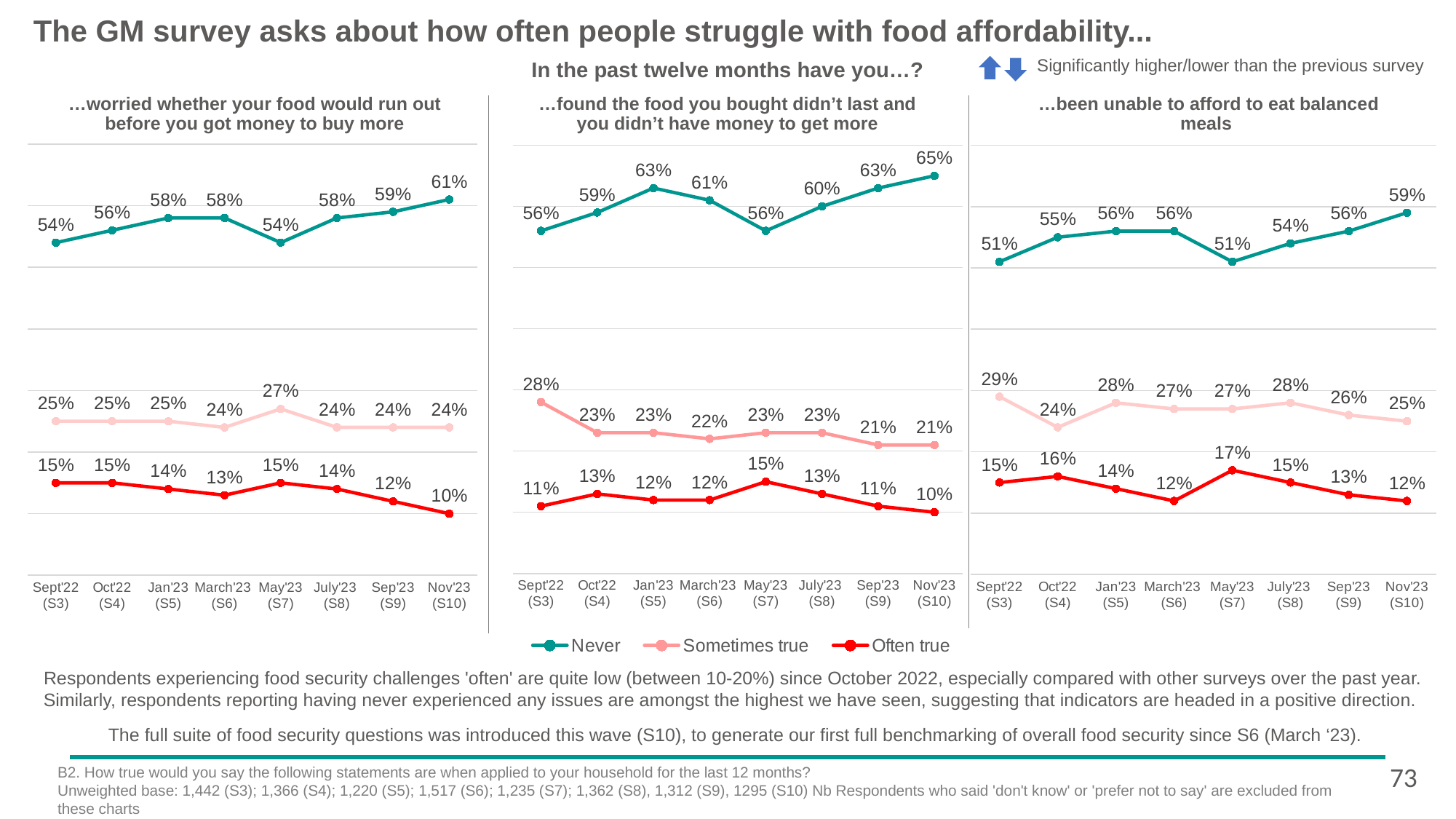
In the chart '…been unable to afford to eat balanced meals', what is the 'Sometimes true' value for Sept'22 (S3)? 29% How many survey waves are plotted along the x axis of each chart? 8 What kind of chart is used for '…found the food you bought didn't last and you didn't have money to get more'? Line chart In the chart '…found the food you bought didn't last and you didn't have money to get more', what is the 'Often true' value for May'23 (S7)? 15% In the chart '…worried whether your food would run out before you got money to buy more', at which survey wave is the 'Often true' value lowest? Nov'23 (S10) In the chart '…found the food you bought didn't last and you didn't have money to get more', at which survey wave is the 'Never' value highest? Nov'23 (S10) In the chart '…worried whether your food would run out before you got money to buy more', what is the 'Never' value for Nov'23 (S10)? 61% In the chart '…been unable to afford to eat balanced meals', which is larger: the 'Sometimes true' value for Sept'22 (S3) or for Oct'22 (S4)? Sept'22 (S3) In the chart '…been unable to afford to eat balanced meals', at which survey wave is the 'Often true' value highest? May'23 (S7) In the chart '…found the food you bought didn't last and you didn't have money to get more', does the 'Sometimes true' series generally rise or fall from Sept'22 (S3) to Nov'23 (S10)? Fall In the chart '…worried whether your food would run out before you got money to buy more', what is the difference between the 'Never' values for Nov'23 (S10) and Sept'22 (S3)? 7 percentage points How many series does the legend list? 3